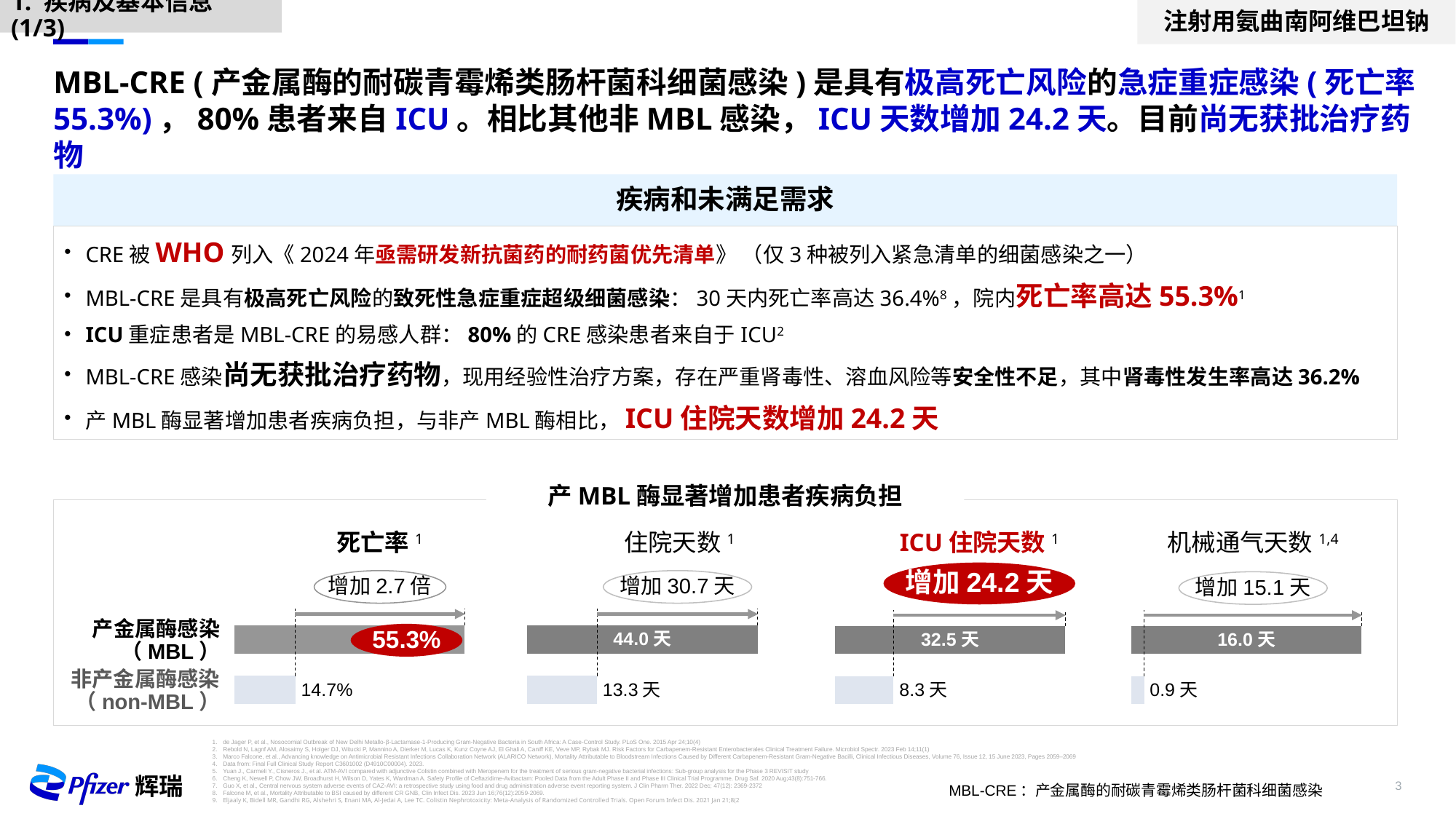
在“产 MBL 酶显著增加患者疾病负担”图表中，非产金属酶感染（non-MBL）的 ICU 住院天数是多少？ 8.3 天 在“产 MBL 酶显著增加患者疾病负担”图表中，非产金属酶感染（non-MBL）的死亡率是多少？ 14.7% 在“产 MBL 酶显著增加患者疾病负担”图表中，住院天数在 MBL 与 non-MBL 之间相差多少天？ 30.7 天 在“产 MBL 酶显著增加患者疾病负担”图表中，机械通气天数 MBL 组与 non-MBL 组哪个更高？ MBL 在“产 MBL 酶显著增加患者疾病负担”图表中，产金属酶感染（MBL）的死亡率是多少？ 55.3% “产 MBL 酶显著增加患者疾病负担”图表比较了多少项指标？ 4 在“产 MBL 酶显著增加患者疾病负担”图表中，ICU 住院天数在 MBL 与 non-MBL 之间相差多少天？ 24.2 天 在“产 MBL 酶显著增加患者疾病负担”图表中，产金属酶感染（MBL）的机械通气天数是多少？ 16.0 天 在“产 MBL 酶显著增加患者疾病负担”图表中，non-MBL 组的四项指标里哪一项的数值最低？ 机械通气天数（0.9 天） 在“产 MBL 酶显著增加患者疾病负担”图表中，产金属酶感染（MBL）的住院天数是多少？ 44.0 天 “产 MBL 酶显著增加患者疾病负担”图表是什么类型的图表？ 条形图（bar chart）